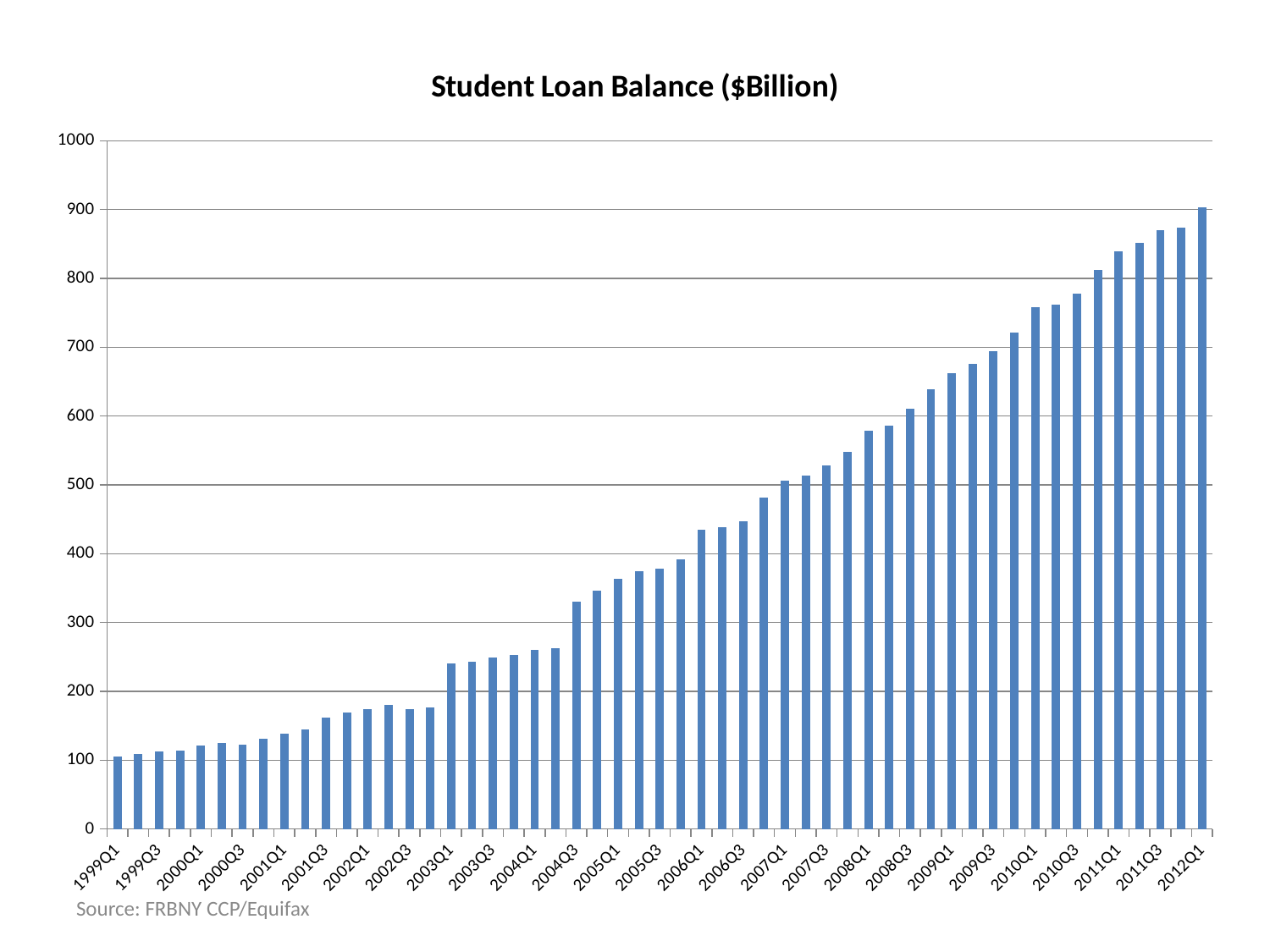
What is the title of the chart? Student Loan Balance ($Billion) Is the value for 2005Q1 greater or less than 300? greater Is the value for 2011Q1 greater or less than 800? greater What kind of chart is shown on the slide? Bar chart What source is cited below the chart? FRBNY CCP/Equifax Which quarter has the highest student loan balance? 2012Q1 Is the value for 2010Q1 greater or less than 700? greater Which quarter has the lowest student loan balance? 1999Q1 Which is larger, the value for 2006Q1 or the value for 2003Q1? 2006Q1 Do the student loan balances generally rise or fall from 1999Q1 to 2012Q1? Rise